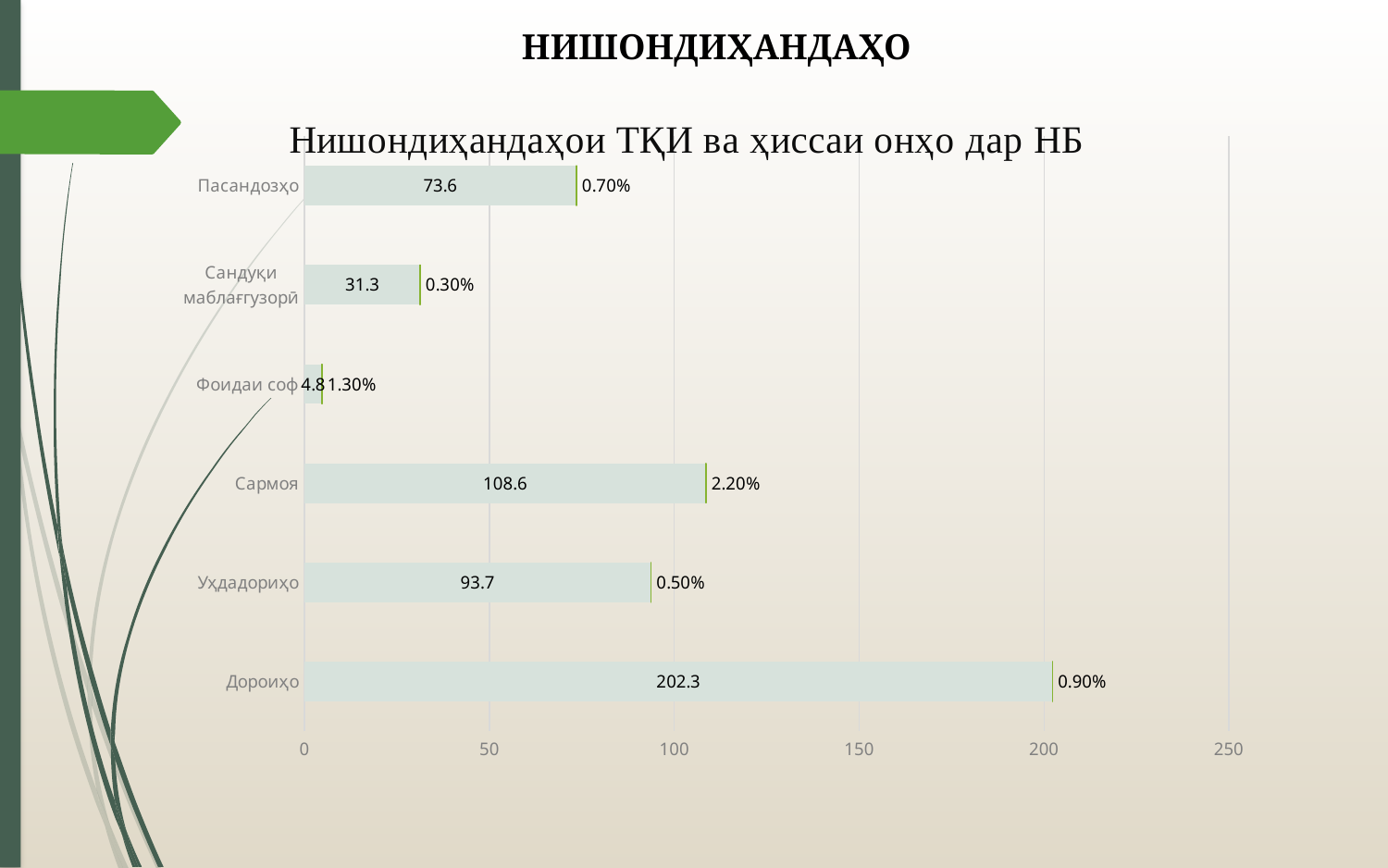
How many categories are shown in the chart? 6 What percentage share is shown next to Фоидаи соф? 1.30% Which category has the lowest bar value? Фоидаи соф Which category has the highest bar value? Дороиҳо Is the value for Сандуқи маблағгузорӣ greater or less than 50? less What is the difference between the values for Дороиҳо and Сармоя? 93.7 What is the title of the chart? Нишондиҳандаҳои ТҚИ ва ҳиссаи онҳо дар НБ What kind of chart is shown on the slide? bar chart What is the value shown for Дороиҳо? 202.3 Which is larger, the value for Уҳдадориҳо or the value for Пасандозҳо? Уҳдадориҳо What is the value shown for Сармоя? 108.6 What percentage share is shown next to Сармоя? 2.20%